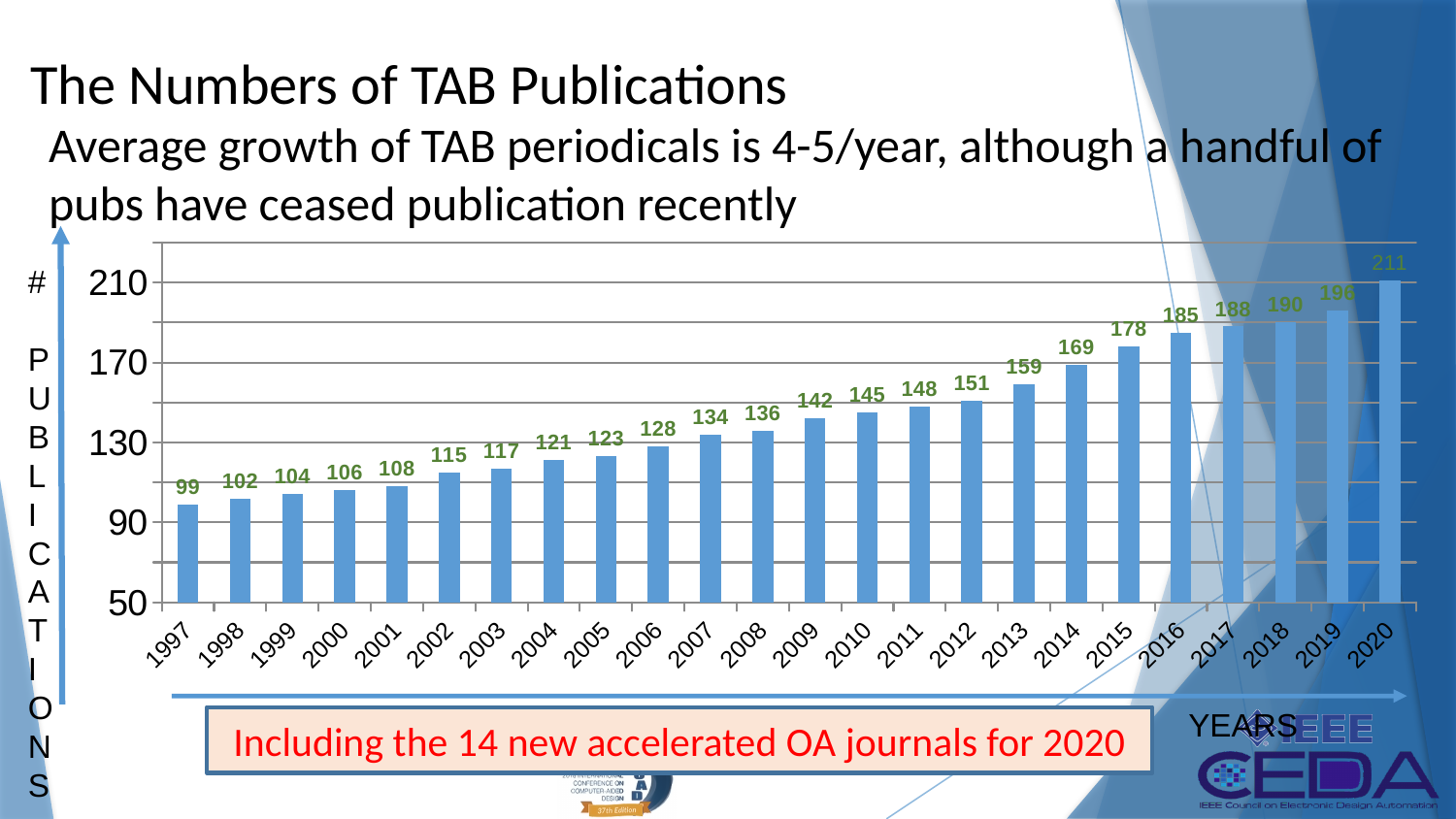
What is the number of TAB publications in 2015? 178 Which year has the lowest number of TAB publications? 1997 What is the number of TAB publications in 2010? 145 Which year has more TAB publications, 2005 or 2008? 2008 What is the difference between the number of publications in 2020 and in 1997? 112 How many years are shown on the x axis of the chart? 24 What kind of chart is used to show the numbers of TAB publications? bar chart Do the numbers of TAB publications rise or fall from 1997 to 2020? rise What is the number of TAB publications in 1997? 99 Is the value for 2016 greater or less than 170? greater Which year has the highest number of TAB publications? 2020 What is the difference between the number of publications in 2014 and in 2013? 10